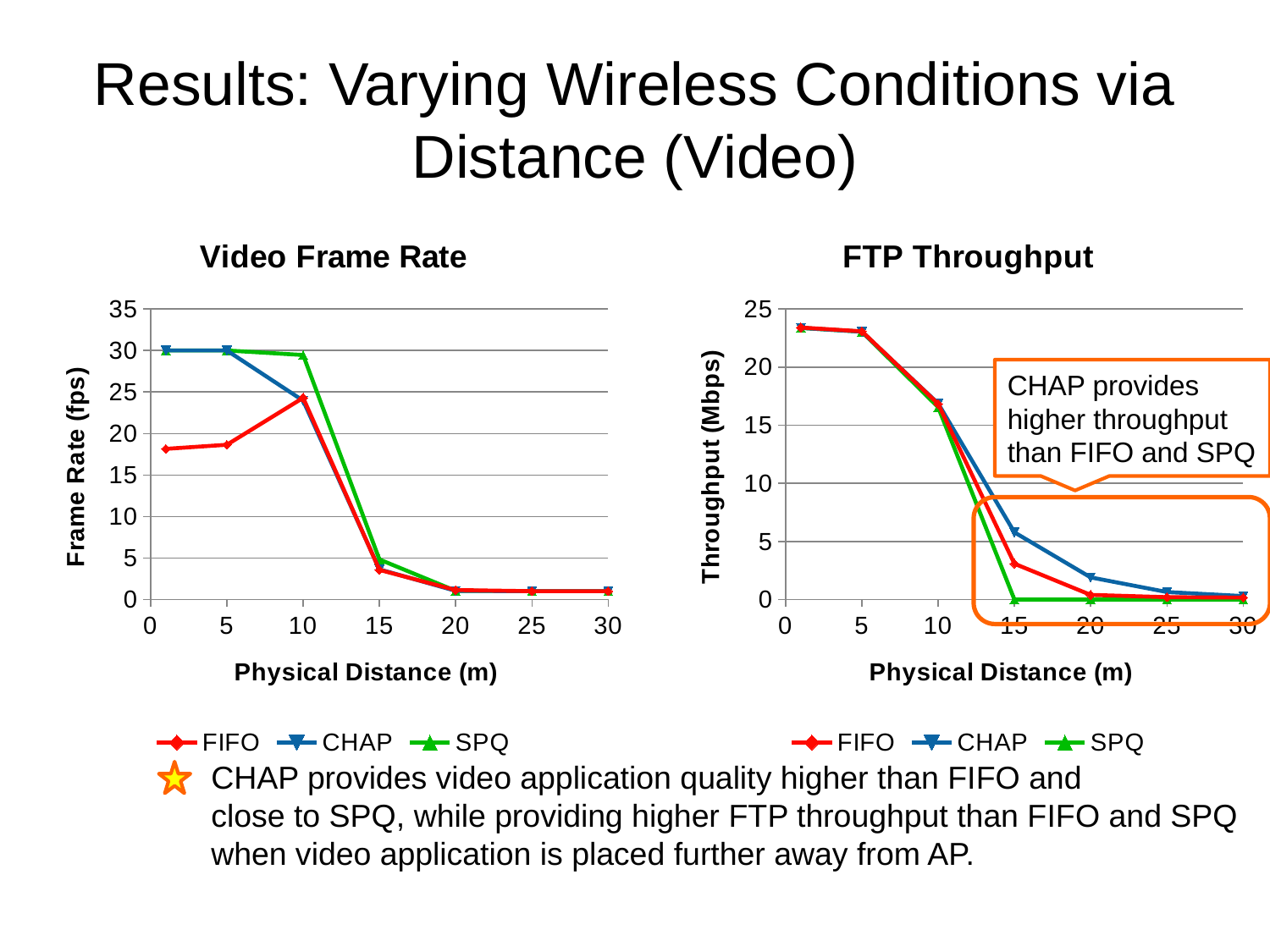
In the Video Frame Rate chart, is the SPQ frame rate at 10 m greater or less than 25? greater What is the y-axis title of the FTP Throughput chart? Throughput (Mbps) In the Video Frame Rate chart, does the frame rate rise or fall as physical distance increases? falls What is the x-axis title of the Video Frame Rate chart? Physical Distance (m) What kind of chart is the Video Frame Rate chart? line chart In the FTP Throughput chart, which has the higher throughput at 15 m, CHAP or SPQ? CHAP How many series does the legend of the FTP Throughput chart list? 3 In the FTP Throughput chart, is the FIFO throughput at 1 m greater or less than 20? greater In the Video Frame Rate chart, which has the higher frame rate at 5 m, CHAP or FIFO? CHAP In the Video Frame Rate chart, is the FIFO frame rate at 5 m greater or less than 20? less In the FTP Throughput chart, how many distance points are plotted for each series? 7